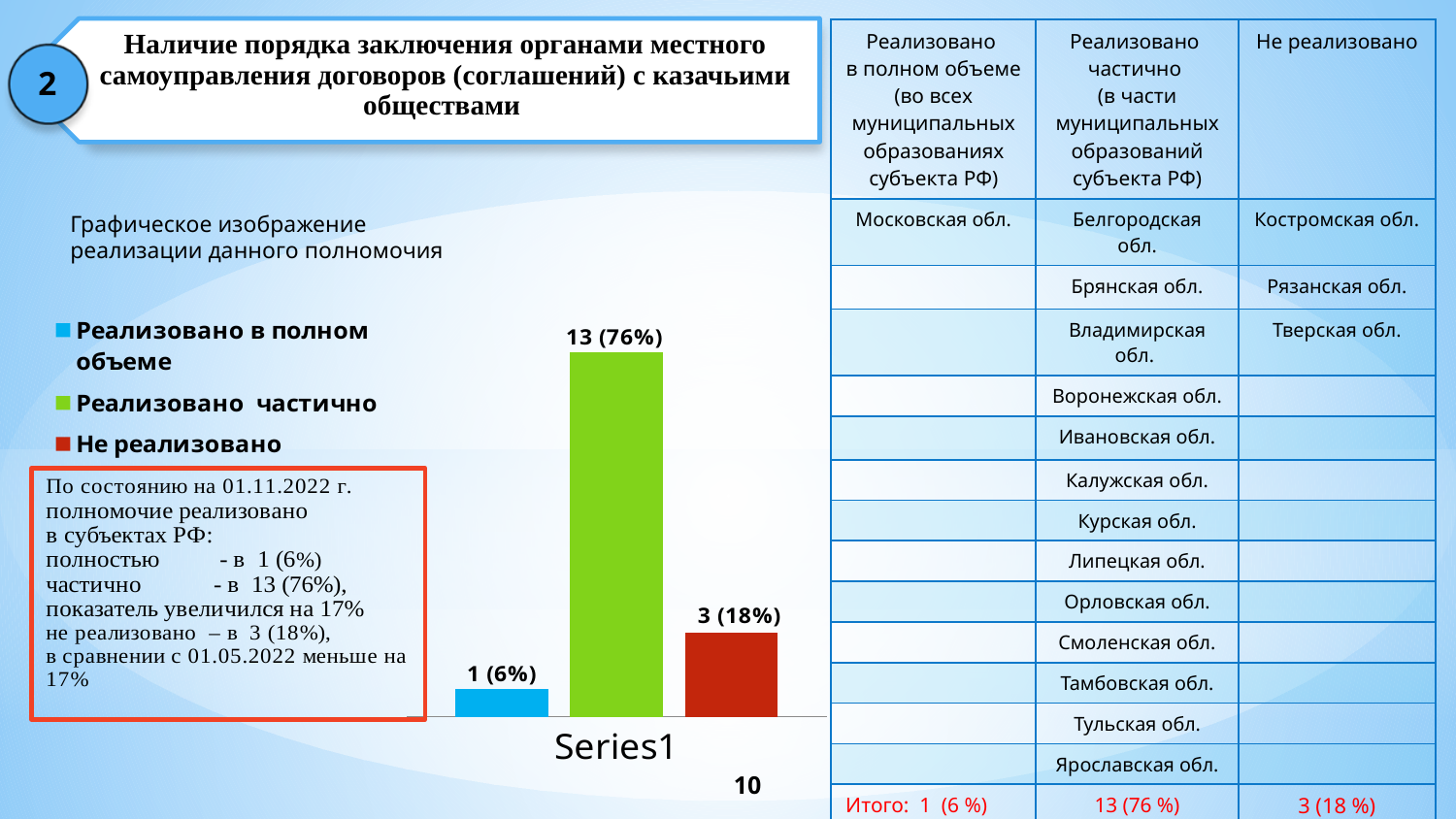
What type of chart is shown on the slide? Bar chart What value is shown for "Реализовано частично" in the chart? 13 (76%) Which category has the highest bar in the chart? Реализовано частично How many entries does the chart legend list? 3 What value is shown for "Не реализовано" in the chart? 3 (18%) What is the difference in count between "Не реализовано" and "Реализовано в полном объеме"? 2 How many bars are plotted in the chart? 3 What is the difference in count between "Реализовано частично" and "Не реализовано"? 10 Which category has the lowest bar in the chart? Реализовано в полном объеме What colour is the bar for "Реализовано частично"? Green What value is shown for "Реализовано в полном объеме" in the chart? 1 (6%) Which is larger: the value for "Не реализовано" or the value for "Реализовано в полном объеме"? Не реализовано